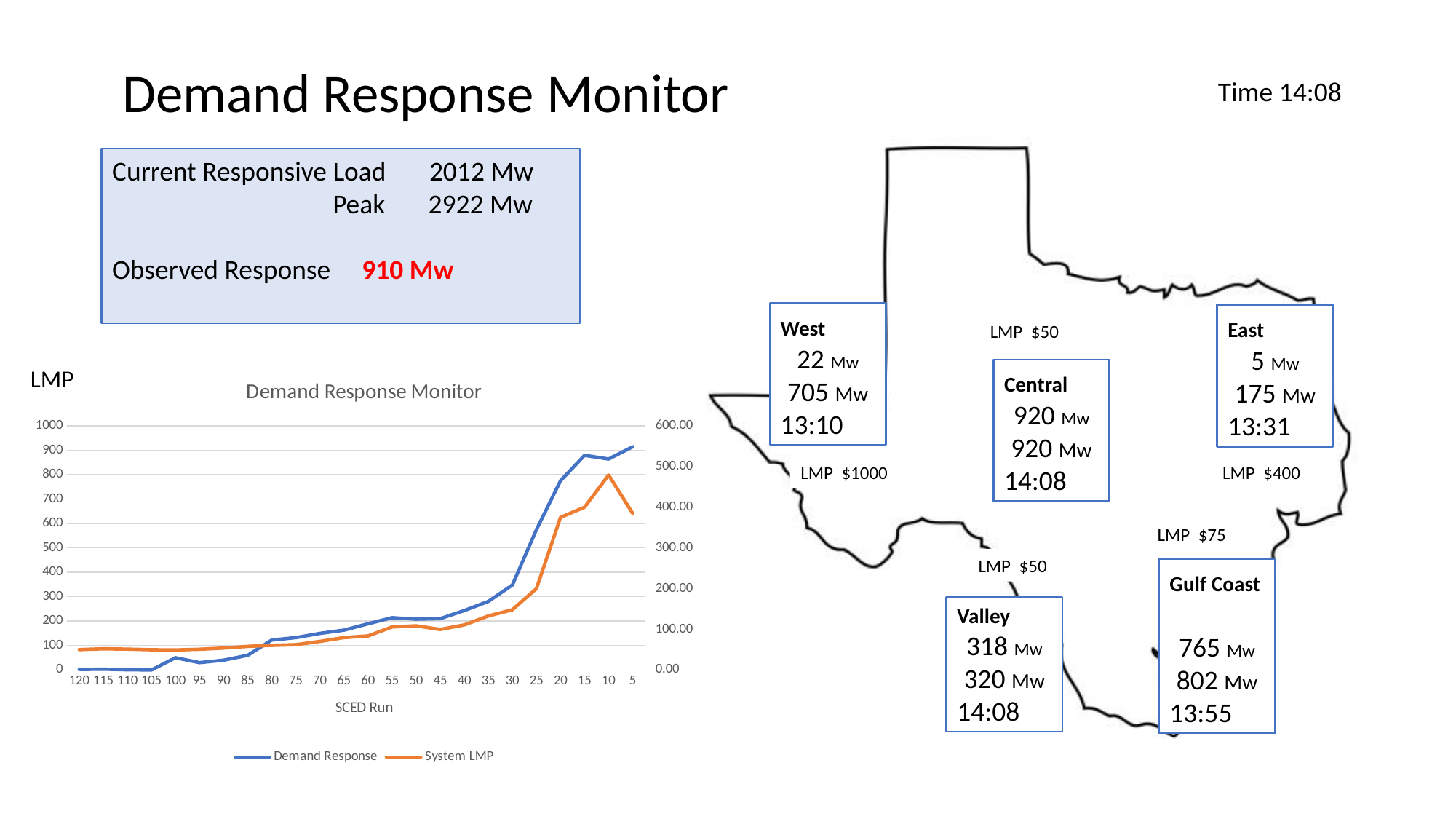
Is the Demand Response value at SCED Run 5 greater or less than 800? greater How many SCED Run values are shown along the x axis of the chart? 24 Is the Demand Response value at SCED Run 120 greater or less than 100? less Is the System LMP value at SCED Run 10 greater or less than 400.00? greater At which SCED Run does the System LMP line reach its highest value? 10 Does the Demand Response line generally rise or fall moving from left to right along the x axis? rise How many series does the chart's legend list? 2 What are the two series named in the chart's legend? Demand Response and System LMP What kind of chart is shown on the slide? line chart What is the title of the chart? Demand Response Monitor At which SCED Run does the Demand Response line reach its highest value? 5